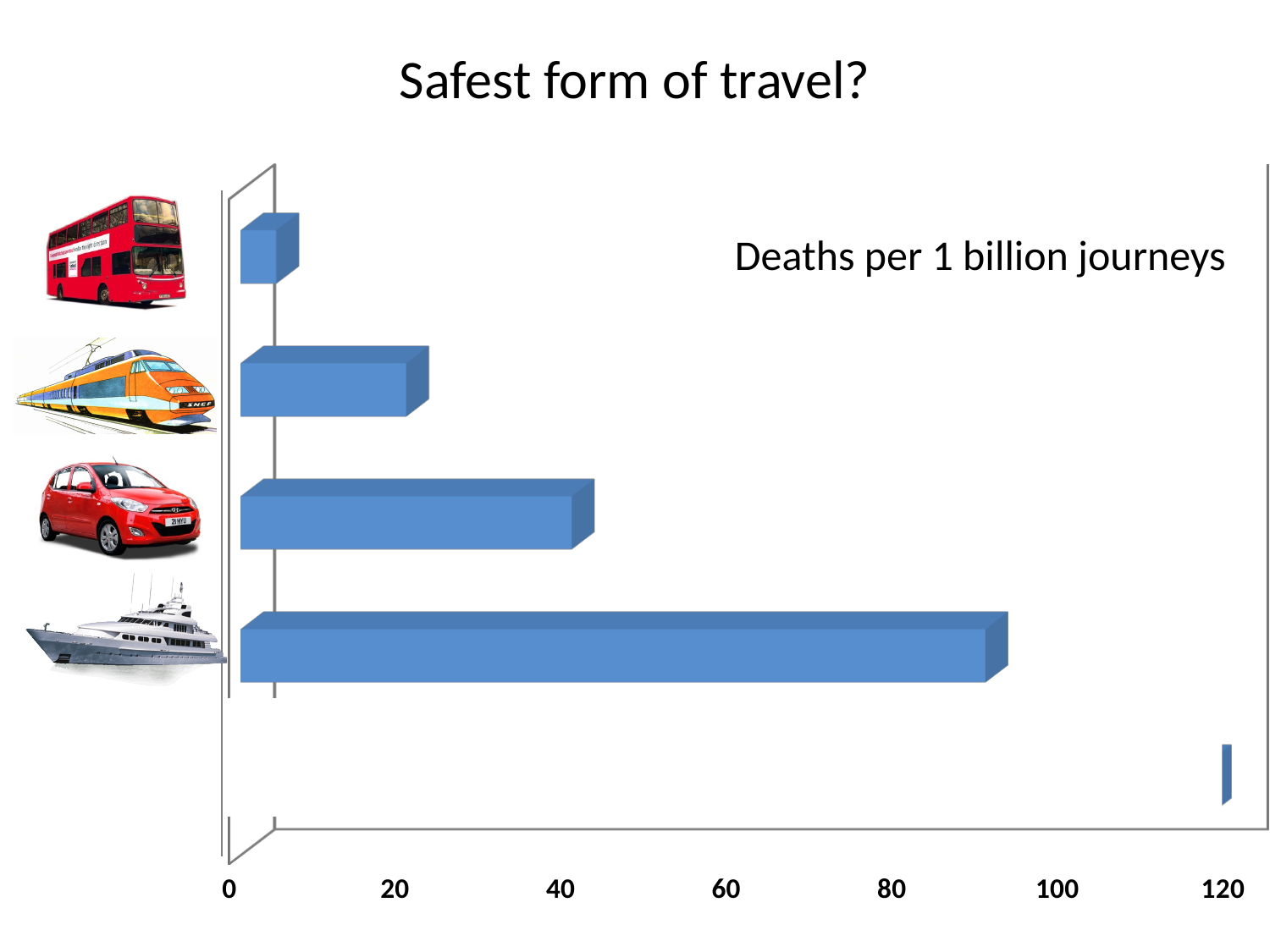
Do the bar lengths increase or decrease going from the top of the chart to the bottom? increase Is the value for the top bar (next to the bus picture) greater or less than 20? less Which is larger, the third bar from the top (car) or the fourth bar from the top (boat)? the fourth bar (boat) Which is larger, the second bar from the top (train) or the third bar from the top (car)? the third bar (car) What quantity does the chart say the bars measure? Deaths per 1 billion journeys Which of the four fully drawn bars is the shortest? the top bar (bus) What is the title of the slide's chart? Safest form of travel? Is the value for the fourth bar from the top (next to the boat picture) greater or less than 100? less What kind of chart is shown on the slide? bar chart Is the value for the third bar from the top (next to the car picture) greater or less than 60? less